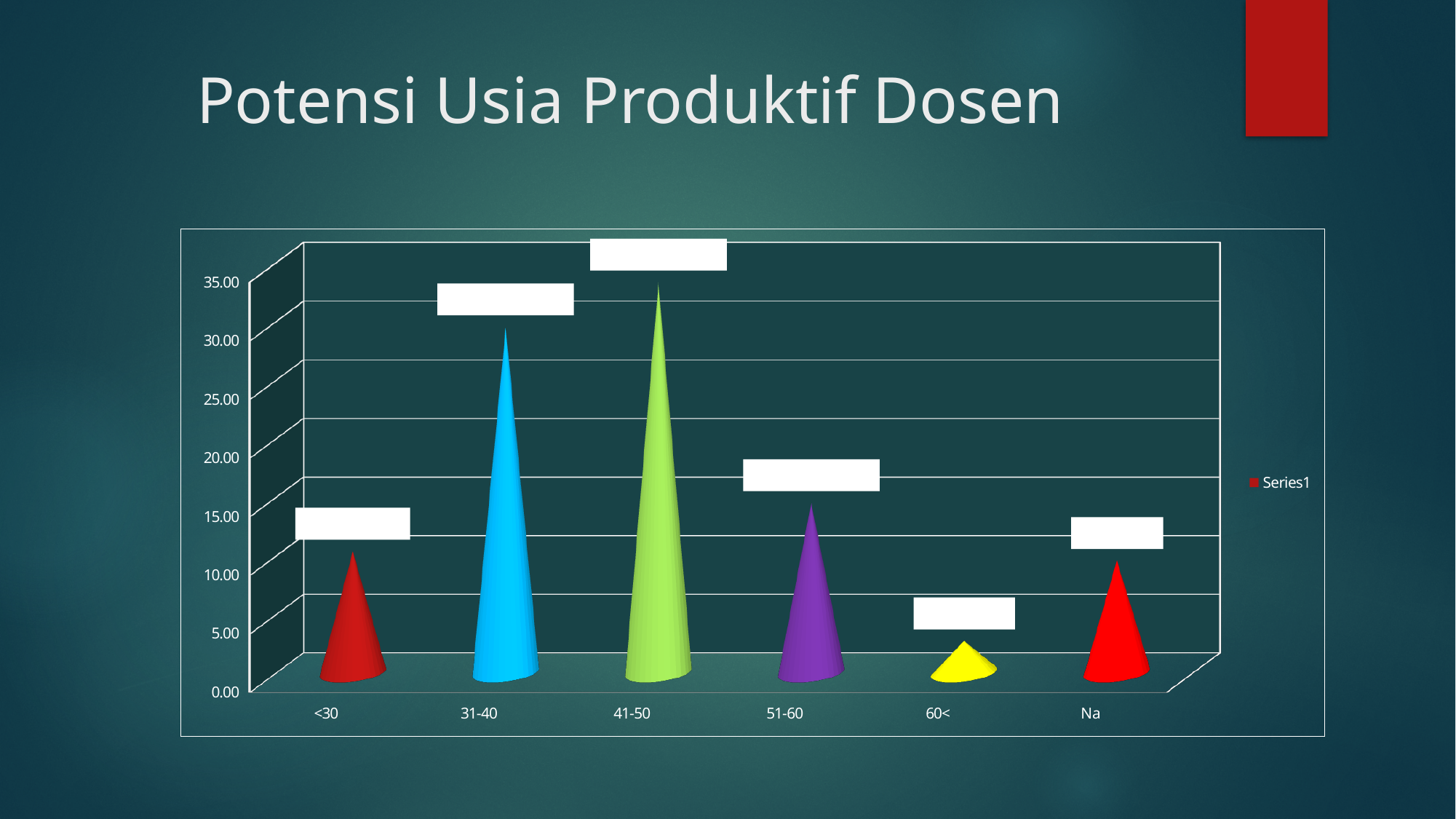
How many series does the chart legend list? 1 Is the value for 60< greater or less than 5.00? less Is the value for 41-50 greater or less than 30.00? greater Which age category has the highest value in the chart? 41-50 Which has the larger value, 31-40 or <30? 31-40 How many age categories are shown on the x axis of the chart? 6 Is the value for <30 greater or less than 15.00? less Which has the larger value, 51-60 or Na? 51-60 What kind of chart is shown on the slide? bar chart Which age category has the lowest value in the chart? 60< What is the title of the slide containing the chart? Potensi Usia Produktif Dosen What is the name of the series shown in the chart legend? Series1